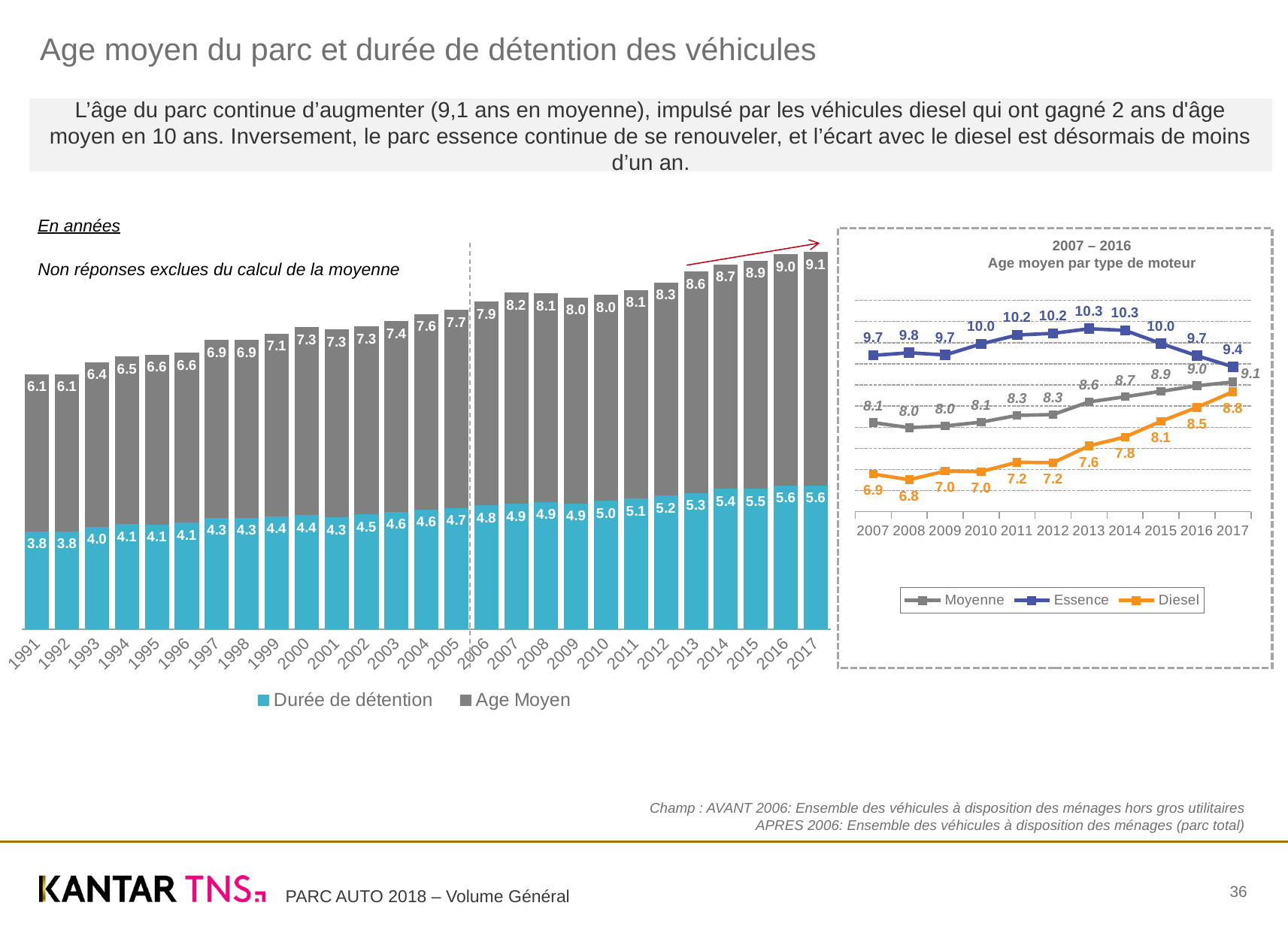
In the bar chart on the left, how many series does the legend list? 2 In the bar chart on the left, what is the Durée de détention value for 1991? 3.8 In the bar chart on the left, does the Durée de détention value generally rise or fall from 1991 to 2017? rise In the bar chart on the left, which year has the highest Age Moyen value? 2017 In the line chart on the right (Age moyen par type de moteur), which year has the lowest Diesel value? 2008 In the bar chart on the left, how many years are shown on the x axis? 27 What kind of chart is the chart on the right (Age moyen par type de moteur)? line chart In the line chart on the right (Age moyen par type de moteur), what is the Diesel value for 2007? 6.9 In the bar chart on the left, what is the Age Moyen value for 2017? 9.1 In the bar chart on the left, what is the difference between the Age Moyen values for 2017 and 1991? 3.0 In the line chart on the right (Age moyen par type de moteur), what is the Essence value for 2013? 10.3 In the line chart on the right (Age moyen par type de moteur), what is the difference between the Essence and Diesel values in 2017? 0.6